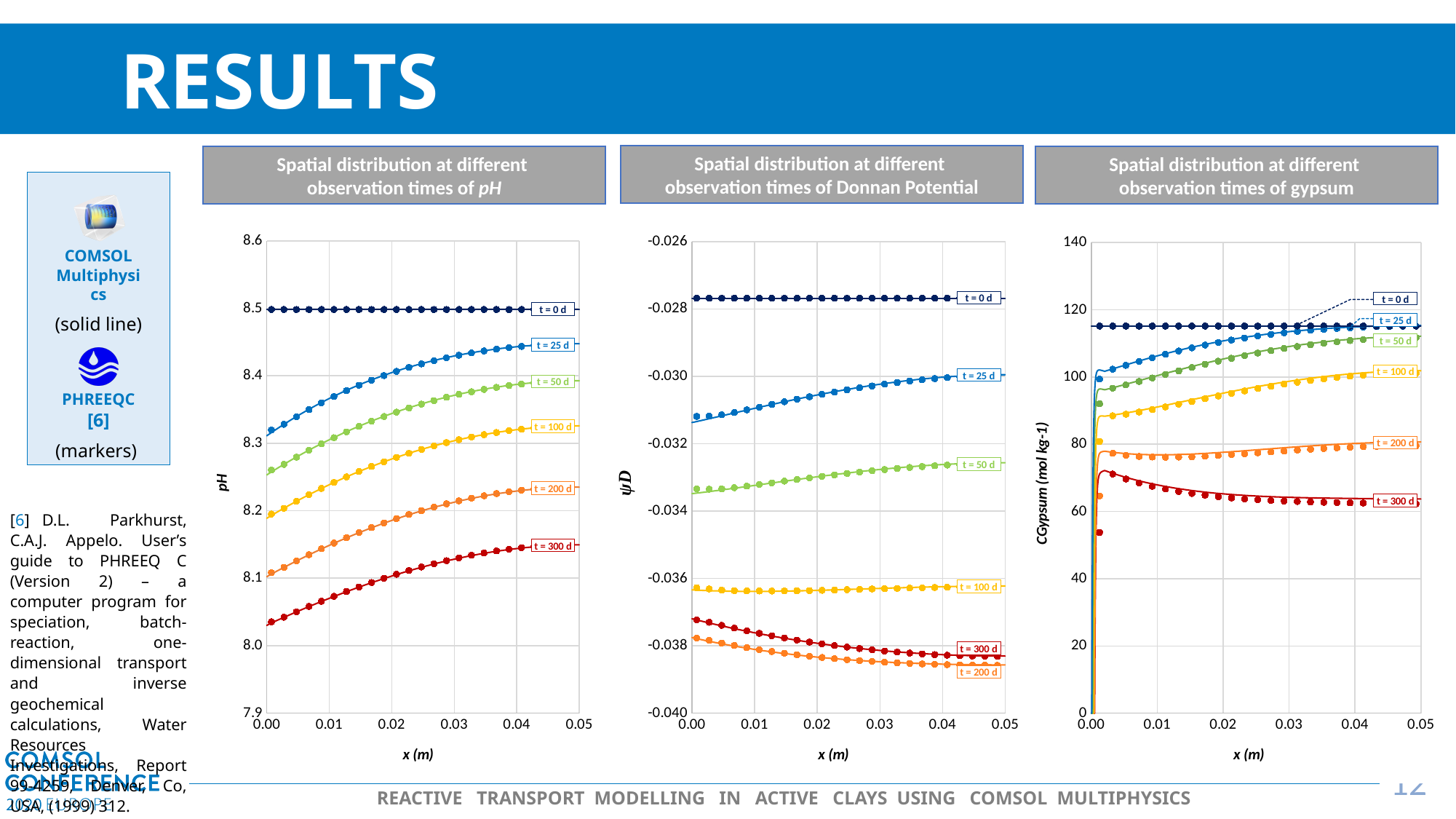
In the pH chart, how many observation-time series are plotted? 6 In the pH chart, which series has the lowest pH values? t = 300 d In the Donnan Potential chart, do the values of the t = 300 d series rise or fall as x increases? fall In the pH chart, which series has higher values at x = 0.04 m, t = 25 d or t = 50 d? t = 25 d In the Donnan Potential chart, which series has the highest values? t = 0 d In the Donnan Potential chart, is the value of the t = 50 d series greater or less than -0.034? greater In the pH chart, do the values of the t = 25 d series rise or fall as x increases? rise In the gypsum chart, is the value of the t = 0 d series greater or less than 100? greater In the pH chart, what is the pH value of the t = 0 d series? 8.5 How many charts are shown on the slide? 3 What is the x-axis label of the gypsum chart? x (m) In the gypsum chart, which series has the lowest values at x = 0.04 m? t = 300 d